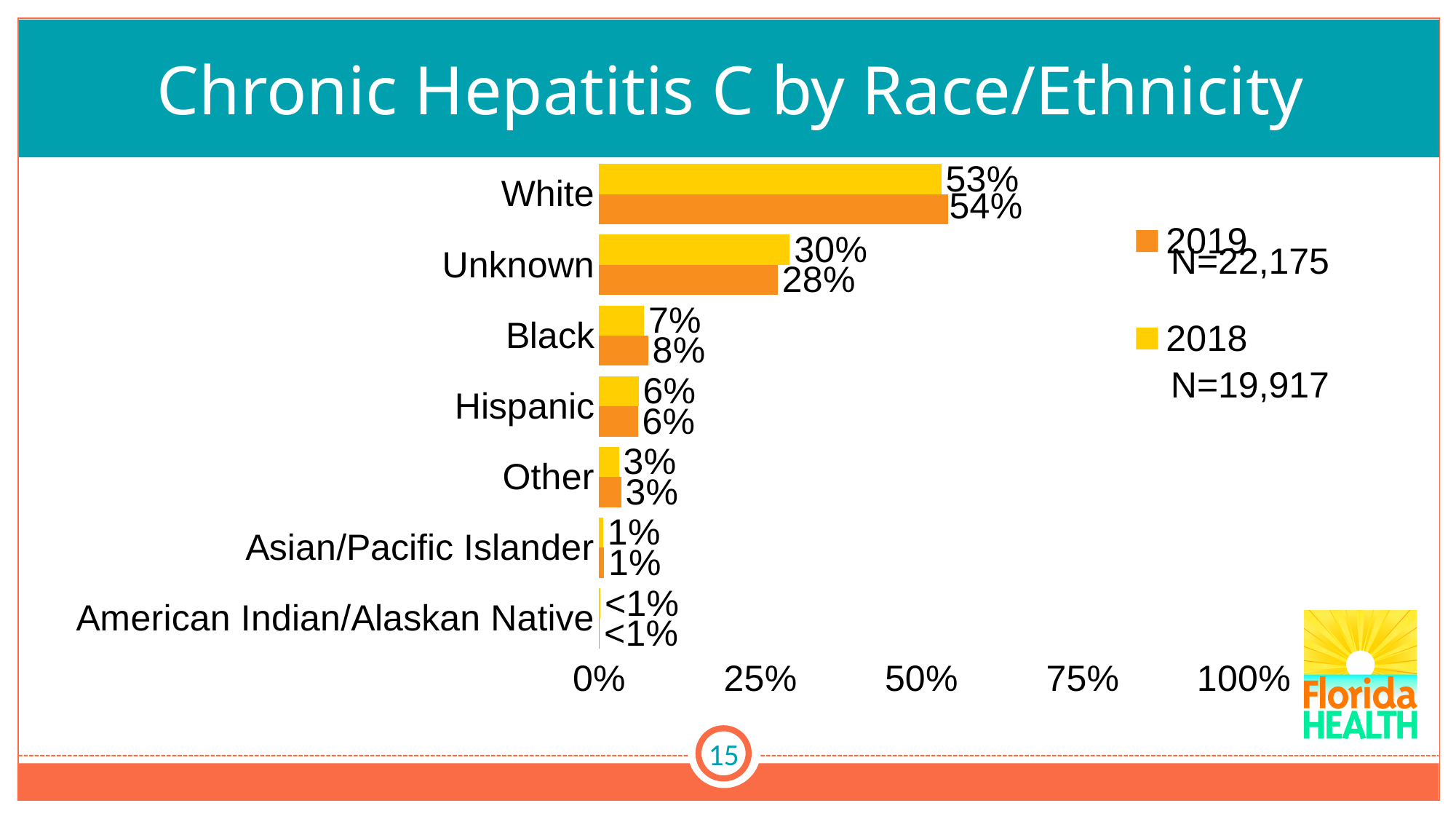
How many series does the legend list? 2 What is the difference between the 2018 and 2019 values for Unknown? 2% What is the 2018 value for Hispanic? 6% What is the 2019 value for Black? 8% Which race/ethnicity category has the highest value in 2019? White What is the 2018 value for Unknown? 30% Which race/ethnicity category has the lowest value in 2018? American Indian/Alaskan Native Which is larger for Black: the 2018 value or the 2019 value? 2019 How many race/ethnicity categories are shown on the chart? 7 What kind of chart is shown on the slide? Bar chart Is the 2019 value for White greater or less than 50%? greater What is the 2019 value for White? 54%